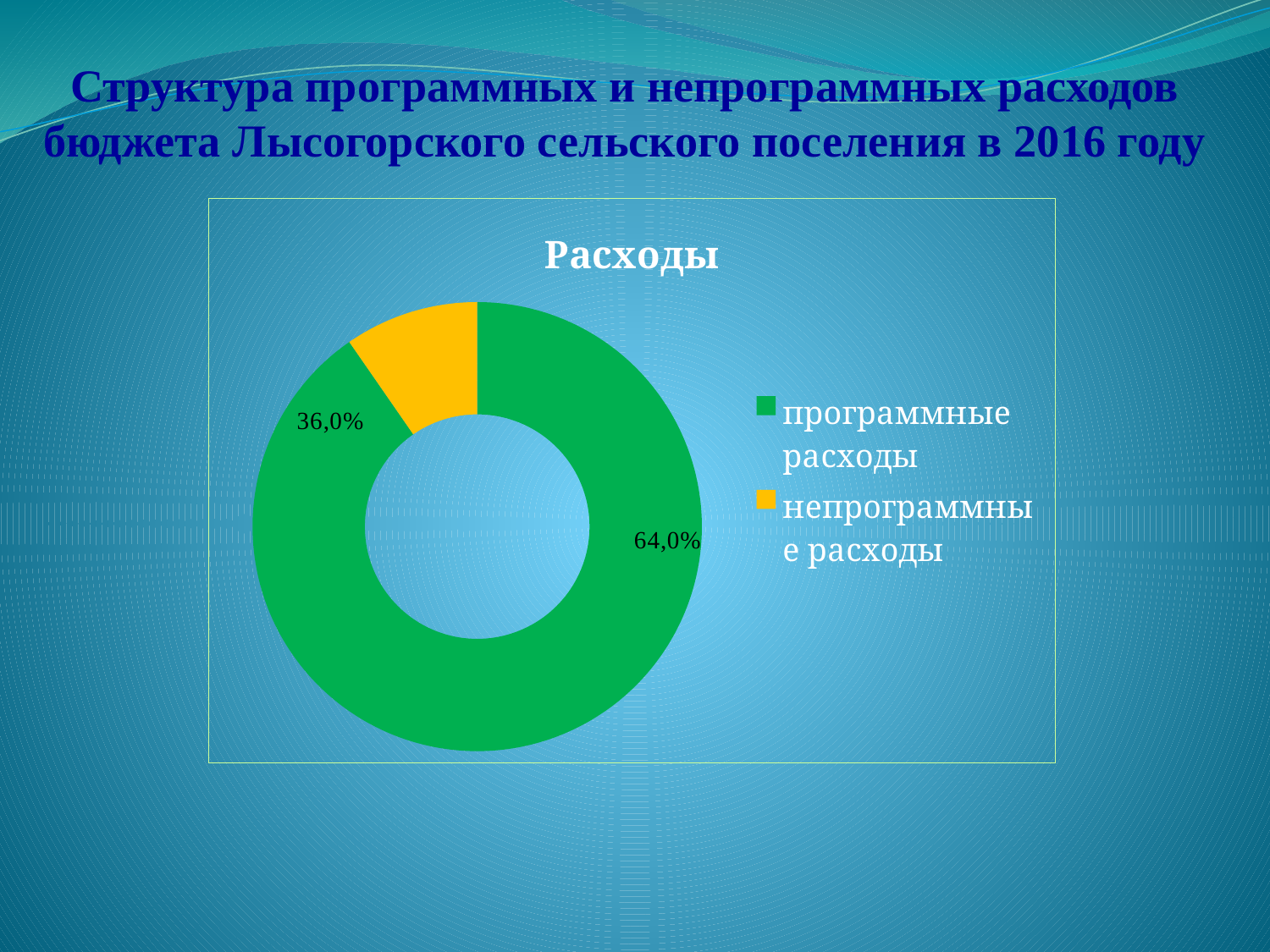
How many categories are shown in the chart? 2 What kind of chart is shown on the slide? Doughnut (pie) chart Which category has the largest share of the chart? программные расходы What colour represents непрограммные расходы in the chart? Yellow What is the title of the chart? Расходы Which category has the smallest share of the chart? непрограммные расходы Which is larger: программные расходы or непрограммные расходы? программные расходы How many entries does the legend list? 2